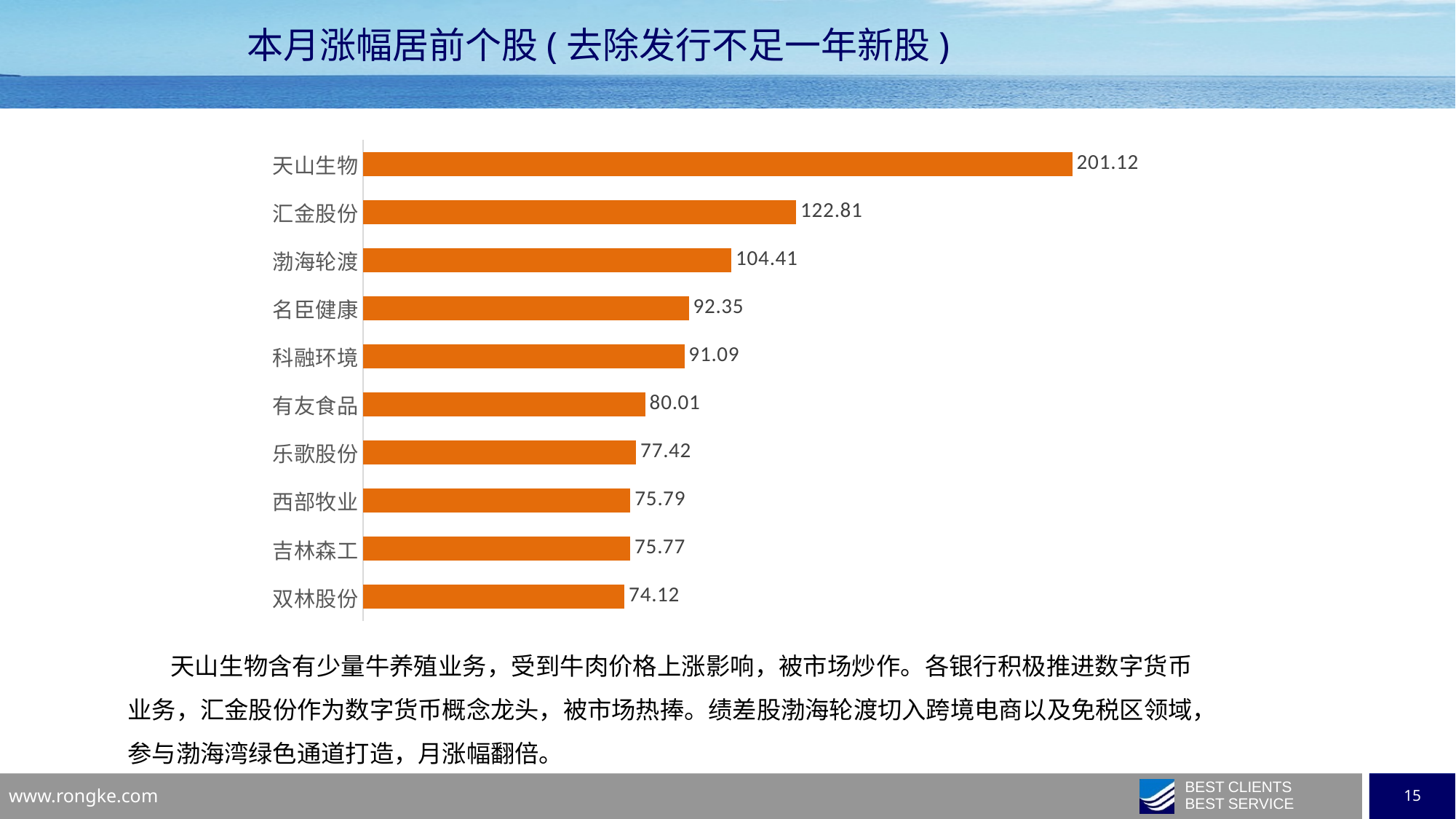
How many stocks are shown in the chart? 10 Which stock has the lowest value in the chart? 双林股份 What is the difference between the values for 名臣健康 and 科融环境? 1.26 Which stock has the highest value in the chart? 天山生物 What is the value for 双林股份? 74.12 What is the value for 有友食品? 80.01 What kind of chart is shown on the slide? bar chart What is the difference between the values for 天山生物 and 汇金股份? 78.31 What is the value for 渤海轮渡? 104.41 What is the title of the slide containing the chart? 本月涨幅居前个股（去除发行不足一年新股） Which is larger, the value for 汇金股份 or the value for 渤海轮渡? 汇金股份 What is the value for 天山生物? 201.12